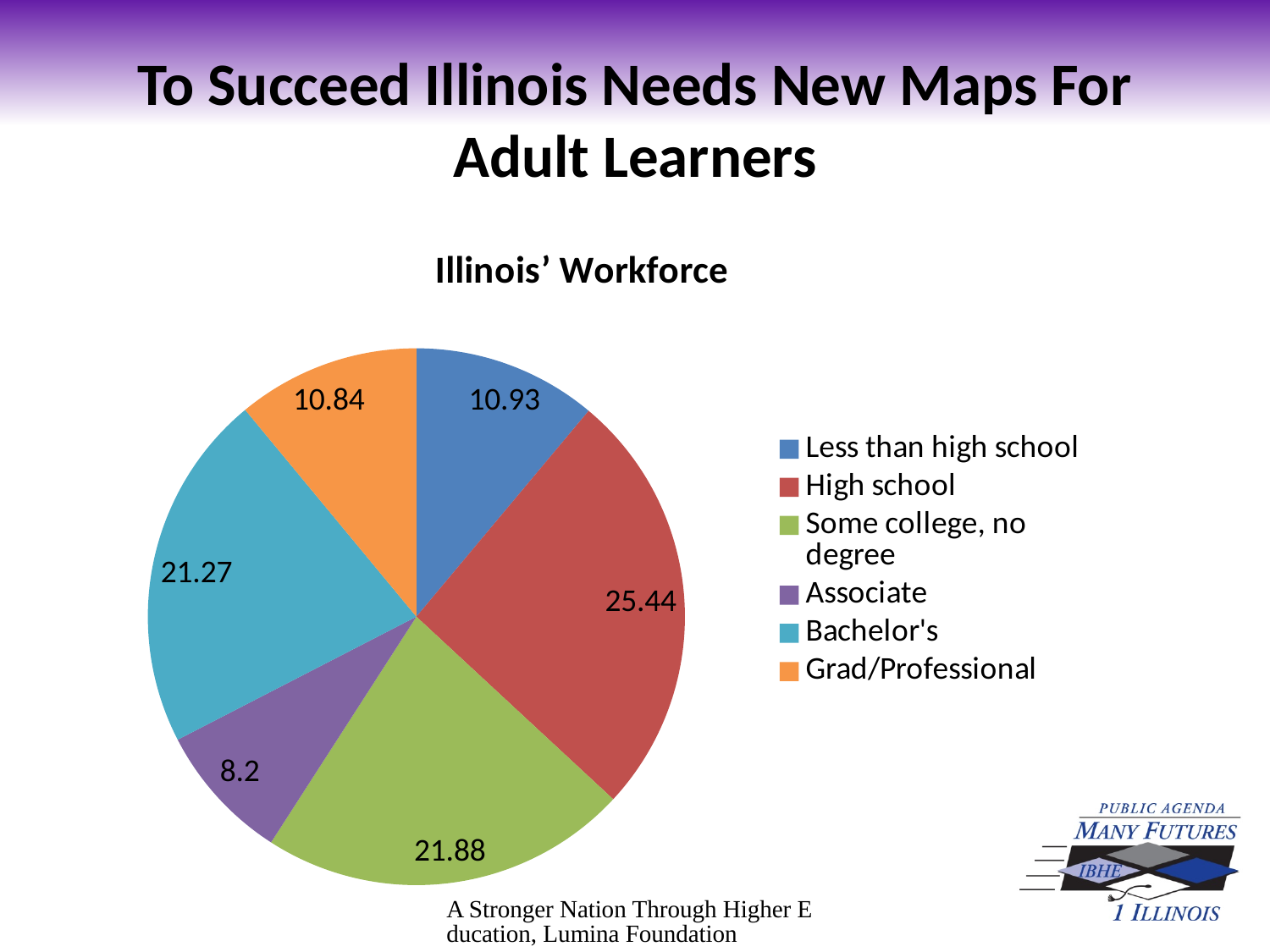
What is the value for Associate? 8.2 What is the value for Bachelor's? 21.27 What is the value for High school? 25.44 What is the title of the chart? Illinois' Workforce How many categories does the legend list? 6 Which category has the smallest slice of the pie? Associate Which category has the largest slice of the pie? High school Which is larger, the value for High school or the value for Less than high school? High school What type of chart is shown on the slide? pie chart What is the difference between the High school value and the Associate value? 17.24 What is the value for Grad/Professional? 10.84 What is the difference between the Some college, no degree value and the Grad/Professional value? 11.04